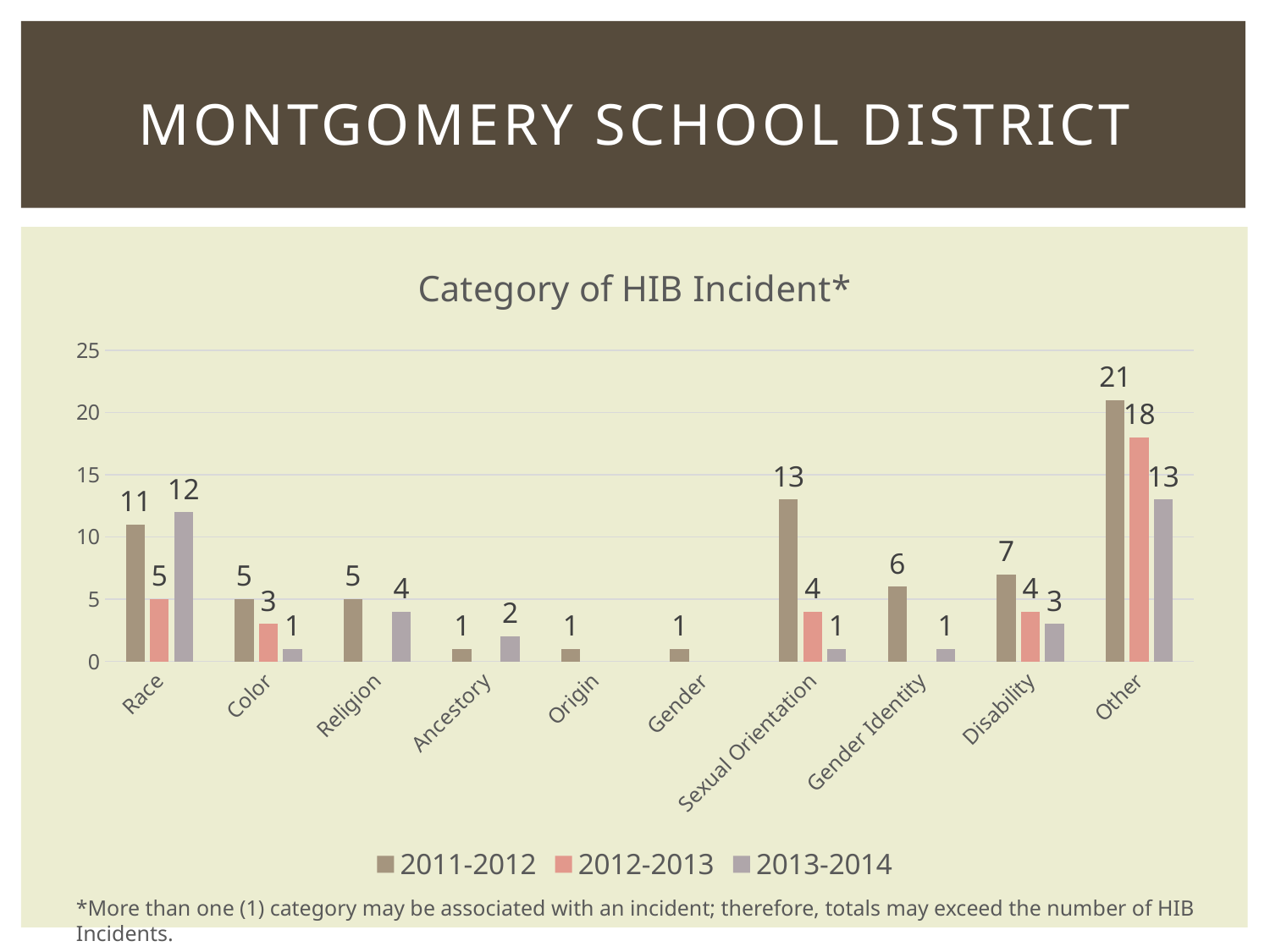
Which is larger for Race: the 2011-2012 value or the 2013-2014 value? 2013-2014 What kind of chart is shown on the slide? Bar chart Which category has the highest value in the 2011-2012 series? Other How many series does the legend list? 3 What is the difference between the 2011-2012 and 2012-2013 values for Other? 3 What is the value for Race in the 2013-2014 series? 12 How many categories are shown on the x axis? 10 What is the title of the chart? Category of HIB Incident* What is the value for Other in the 2012-2013 series? 18 What is the value for Sexual Orientation in the 2011-2012 series? 13 Which category has the highest value in the 2013-2014 series? Other What is the value for Disability in the 2013-2014 series? 3